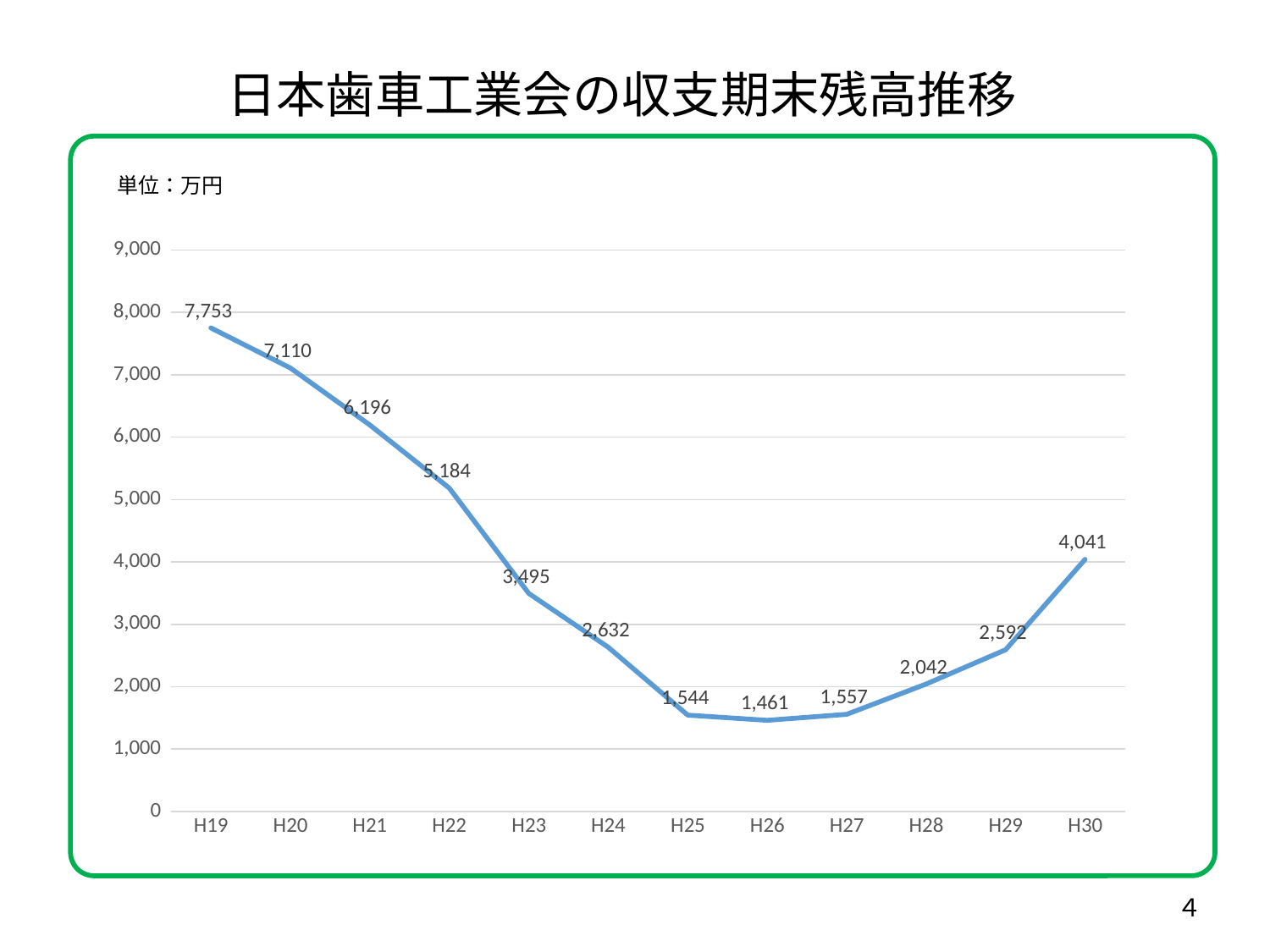
Is the value for H22 greater or less than 5,000? greater Which year has the lowest value? H26 How many years are plotted on the x axis? 12 Do the values rise or fall from H19 to H26? fall Which year has the highest value? H19 Which is larger, the value for H23 or the value for H30? H30 What is the difference between the values for H30 and H29? 1,449 What is the value for H30? 4,041 What is the value for H26? 1,461 What is the difference between the values for H19 and H20? 643 What kind of chart is shown on the slide? line chart What is the value for H19? 7,753